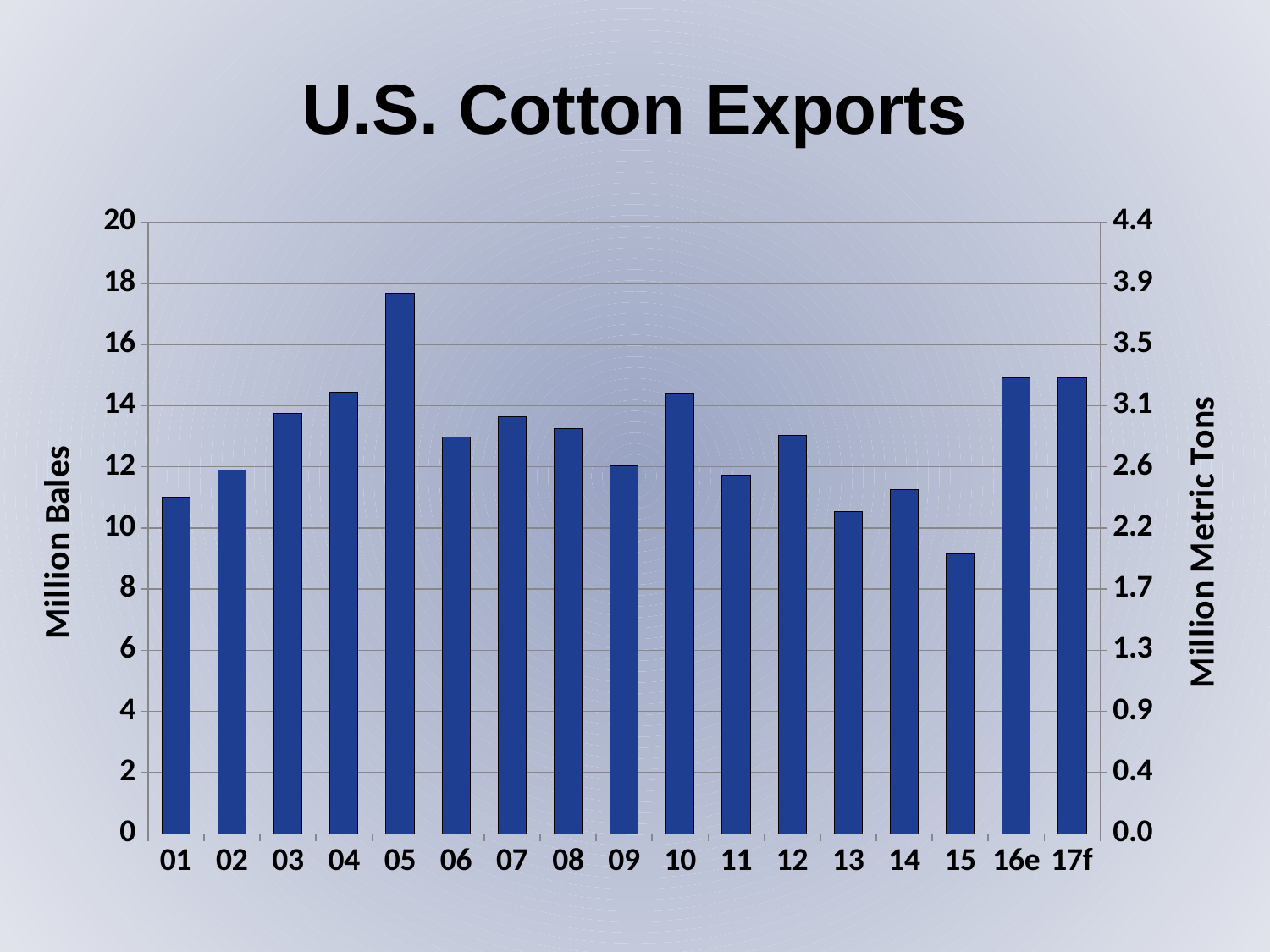
What is the title of the chart? U.S. Cotton Exports Is the value for 05 greater or less than 16 million bales? greater What is the label on the left vertical axis? Million Bales Which is larger, the value for 04 or the value for 13? 04 Which year has the highest cotton exports? 05 Is the value for 09 greater or less than 14 million bales? less Is the value for 16e greater or less than 16 million bales? less Which year has the lowest cotton exports? 15 What kind of chart is shown on the slide? bar chart How many bars (years) are plotted on the chart? 17